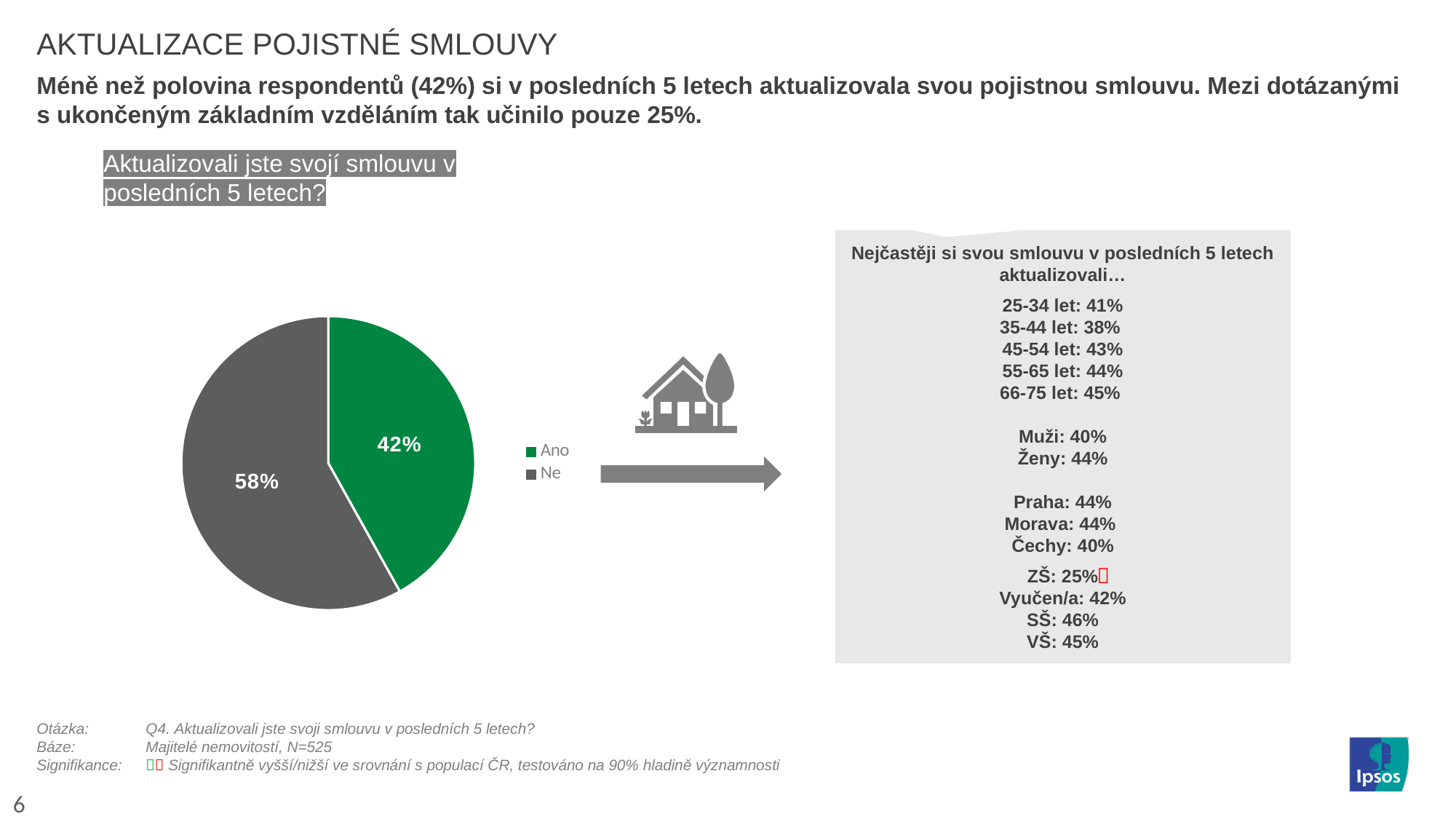
What kind of chart is shown on the slide? pie chart What question is the pie chart titled with? Aktualizovali jste svojí smlouvu v posledních 5 letech? Which is larger in the pie chart, "Ano" or "Ne"? Ne What is the difference in percentage points between the "Ne" and "Ano" slices? 16 Which slice of the pie chart is the smallest? Ano How many slices does the pie chart have? 2 What percentage of respondents answered "Ne" in the pie chart? 58% What percentage of respondents answered "Ano" in the pie chart? 42% Which slice of the pie chart is the largest? Ne What colour is the "Ano" slice in the pie chart? green How many entries does the legend of the pie chart list? 2 What share of the pie does the "Ano" slice represent? 42%